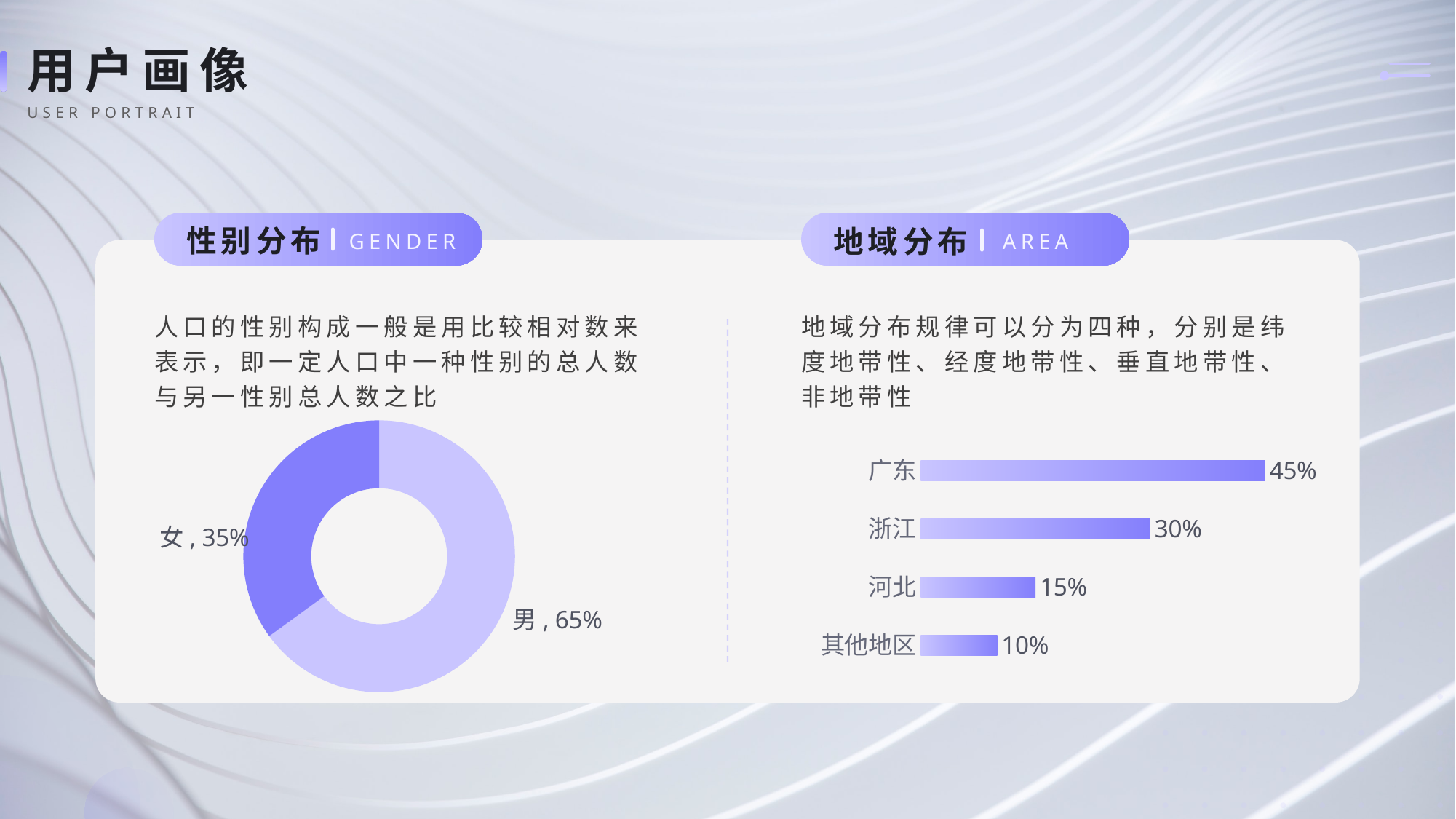
In the 性别分布 (Gender) chart, what share is labelled for 女? 35% In the 性别分布 (Gender) chart, which slice is larger, 男 or 女? 男 In the 地域分布 (Area) chart, what is the difference between 广东 and 浙江? 15% In the 性别分布 (Gender) chart, what share is labelled for 男? 65% In the 性别分布 (Gender) chart, how many slices are there? 2 In the 地域分布 (Area) chart, how many regions are shown? 4 What kind of chart is the 地域分布 (Area) chart? Bar chart In the 地域分布 (Area) chart, which region has the highest value? 广东 In the 地域分布 (Area) chart, what is the value for 河北? 15% In the 地域分布 (Area) chart, which region has the lowest value? 其他地区 In the 地域分布 (Area) chart, what is the value for 广东? 45% What kind of chart is the 性别分布 (Gender) chart? Doughnut chart